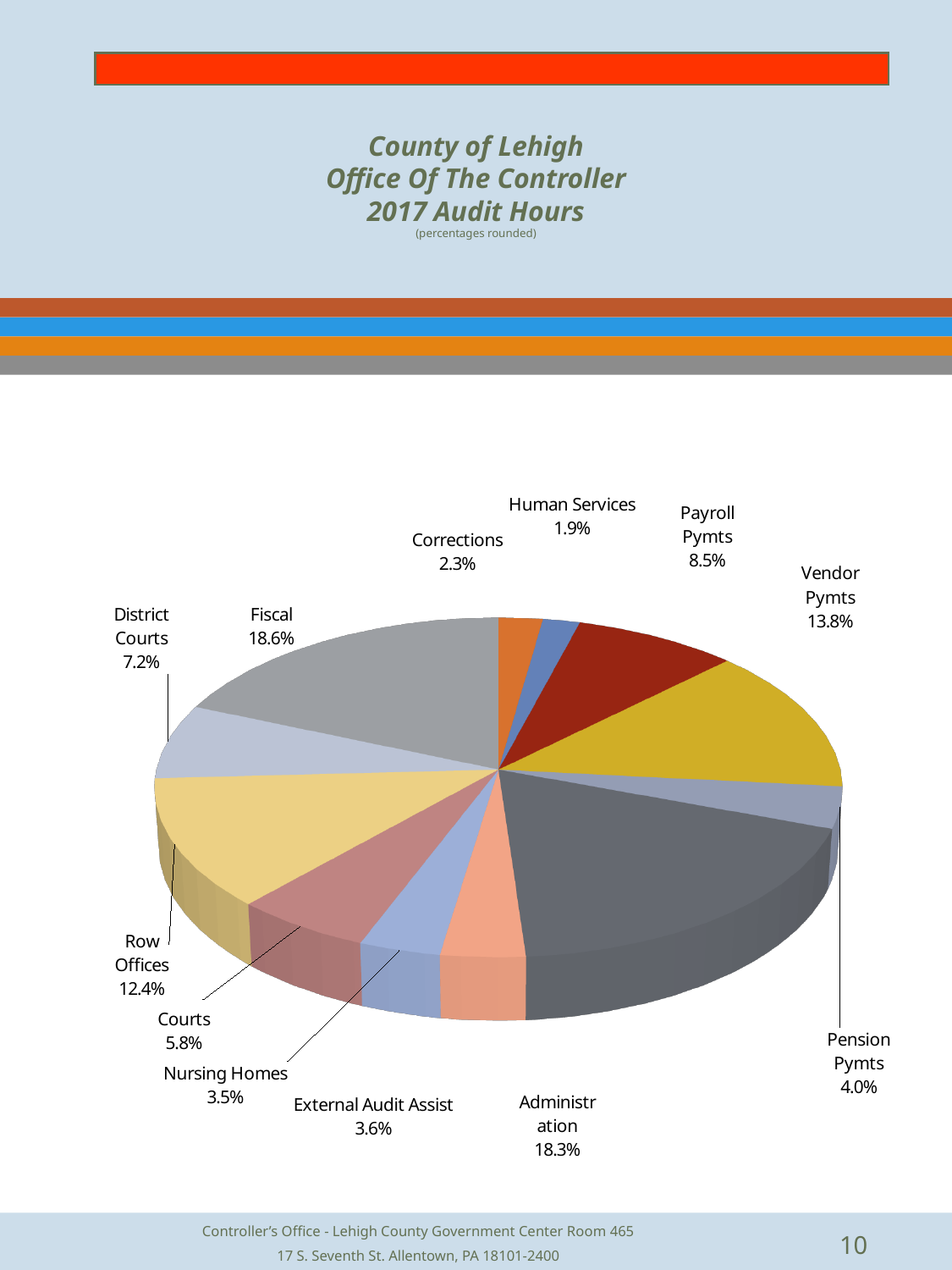
What is the title of the chart? County of Lehigh Office Of The Controller 2017 Audit Hours Which has a larger share, Pension Pymts or Corrections? Pension Pymts Which has a larger share, Courts or District Courts? District Courts What percentage of 2017 audit hours is shown for Fiscal? 18.6% What percentage is labelled for Nursing Homes? 3.5% What percentage of 2017 audit hours is shown for Vendor Pymts? 13.8% What kind of chart is shown on the slide? Pie chart How many categories are shown in the pie chart? 12 What is the difference in percentage points between Administration and Payroll Pymts? 9.8 Which category has the smallest share of 2017 audit hours? Human Services What percentage is labelled for Row Offices? 12.4% Which category has the largest share of 2017 audit hours? Fiscal